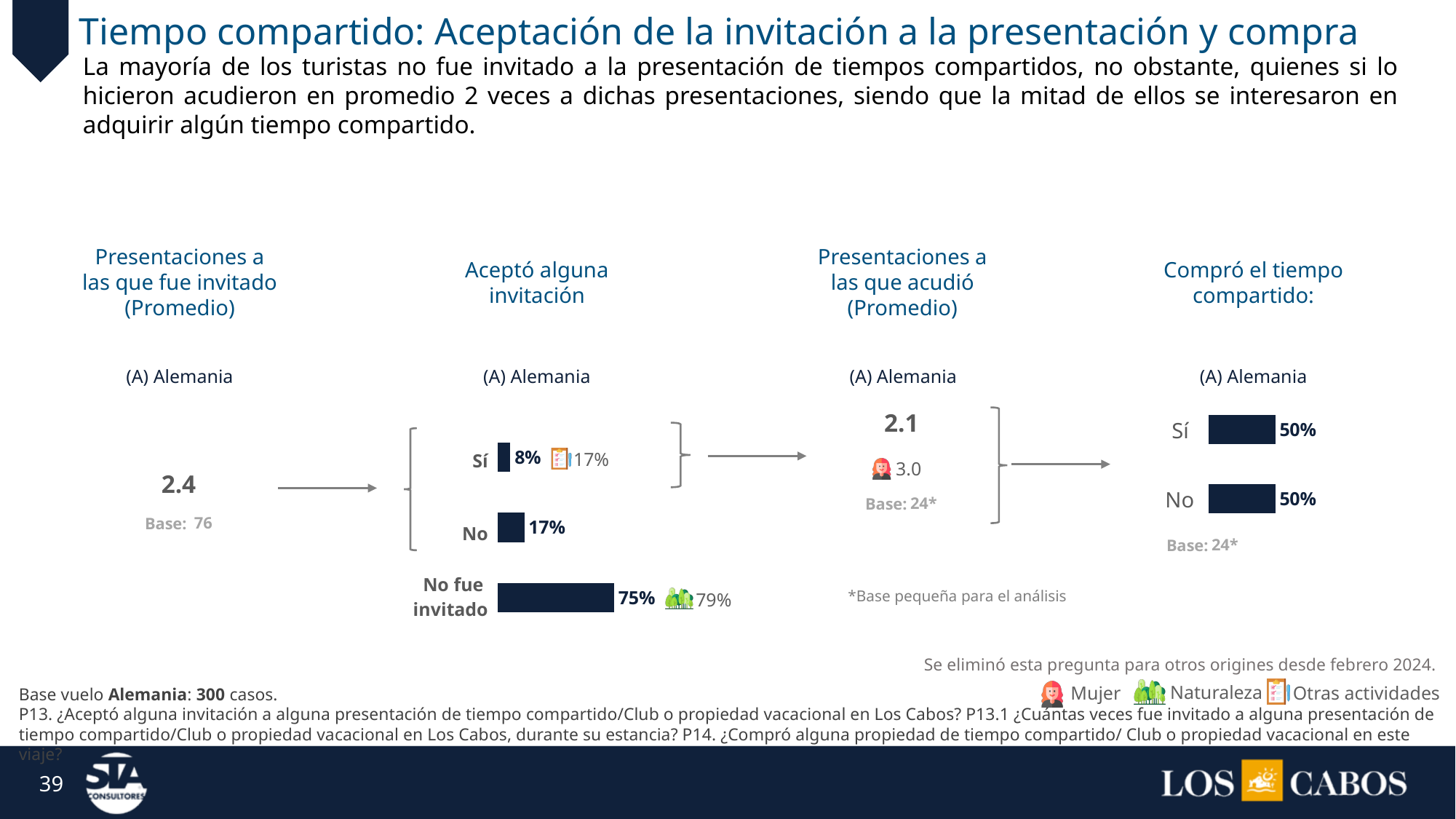
In the 'Aceptó alguna invitación' chart, what is the difference between 'No' and 'Sí'? 9% In the 'Aceptó alguna invitación' chart, which category has the highest value? No fue invitado In the 'Compró el tiempo compartido' chart, what is the value for 'No'? 50% In the 'Aceptó alguna invitación' chart, which category has the lowest value? Sí In the 'Compró el tiempo compartido' chart, what is the value for 'Sí'? 50% How many categories does the 'Aceptó alguna invitación' chart show? 3 What kind of chart is the 'Compró el tiempo compartido' chart? Bar chart In the 'Aceptó alguna invitación' chart, what is the value for 'No'? 17% In the 'Aceptó alguna invitación' chart, what is the value for 'Sí'? 8% In the 'Aceptó alguna invitación' chart, what is the value for 'No fue invitado'? 75% In the 'Aceptó alguna invitación' chart, which is larger, 'No' or 'Sí'? No What is the base shown under the 'Compró el tiempo compartido' chart? Base: 24*